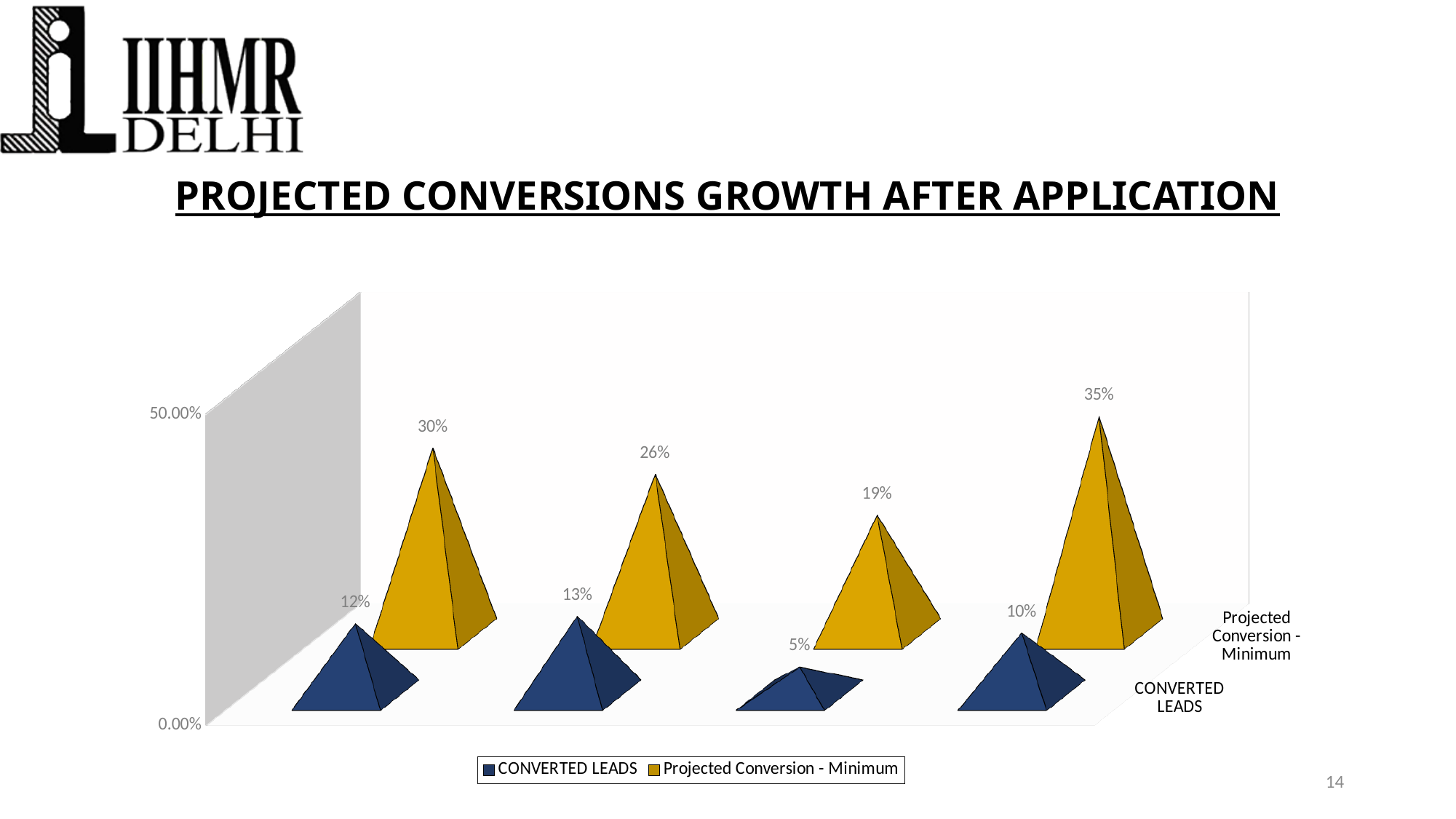
What kind of chart is shown on the slide? 3D bar chart (pyramid-shaped bars) Which position (first, second, third or fourth from the left) has the lowest CONVERTED LEADS value? third What is the difference between the highest and lowest Projected Conversion - Minimum values? 16% What is the value of the first CONVERTED LEADS pyramid from the left? 12% Which position (first, second, third or fourth from the left) has the highest Projected Conversion - Minimum value? fourth What is the difference between the Projected Conversion - Minimum value and the CONVERTED LEADS value at the first position from the left? 18% How many data points does each series have? 4 What is the value of the third CONVERTED LEADS pyramid from the left? 5% How many series does the legend list? 2 Which is larger: the CONVERTED LEADS value at the second position or at the fourth position from the left? second position (13%) What is the title of the chart? PROJECTED CONVERSIONS GROWTH AFTER APPLICATION What is the value of the fourth Projected Conversion - Minimum pyramid from the left? 35%